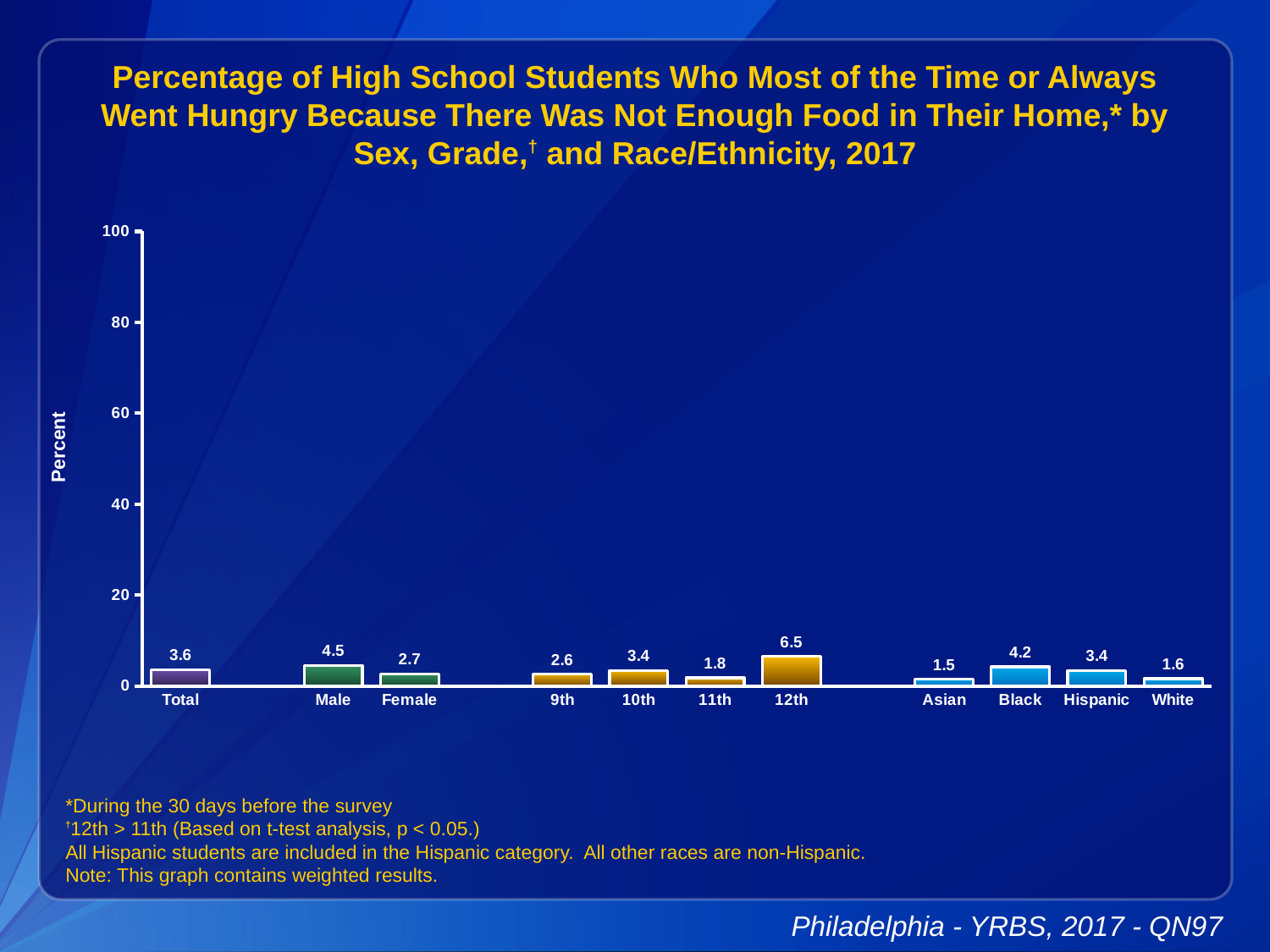
What is the value for Male? 4.5 Which is larger, the value for 12th grade or the value for 11th grade? 12th Is the value for Black greater or less than 20? less What is the value for Asian? 1.5 What is the label of the y axis? Percent Which category has the highest value? 12th What kind of chart is this? bar chart What is the difference between the values for Male and Female? 1.8 How many categories are shown on the x axis? 11 Which category has the lowest value? Asian What is the value for 12th grade? 6.5 What is the value for Total? 3.6